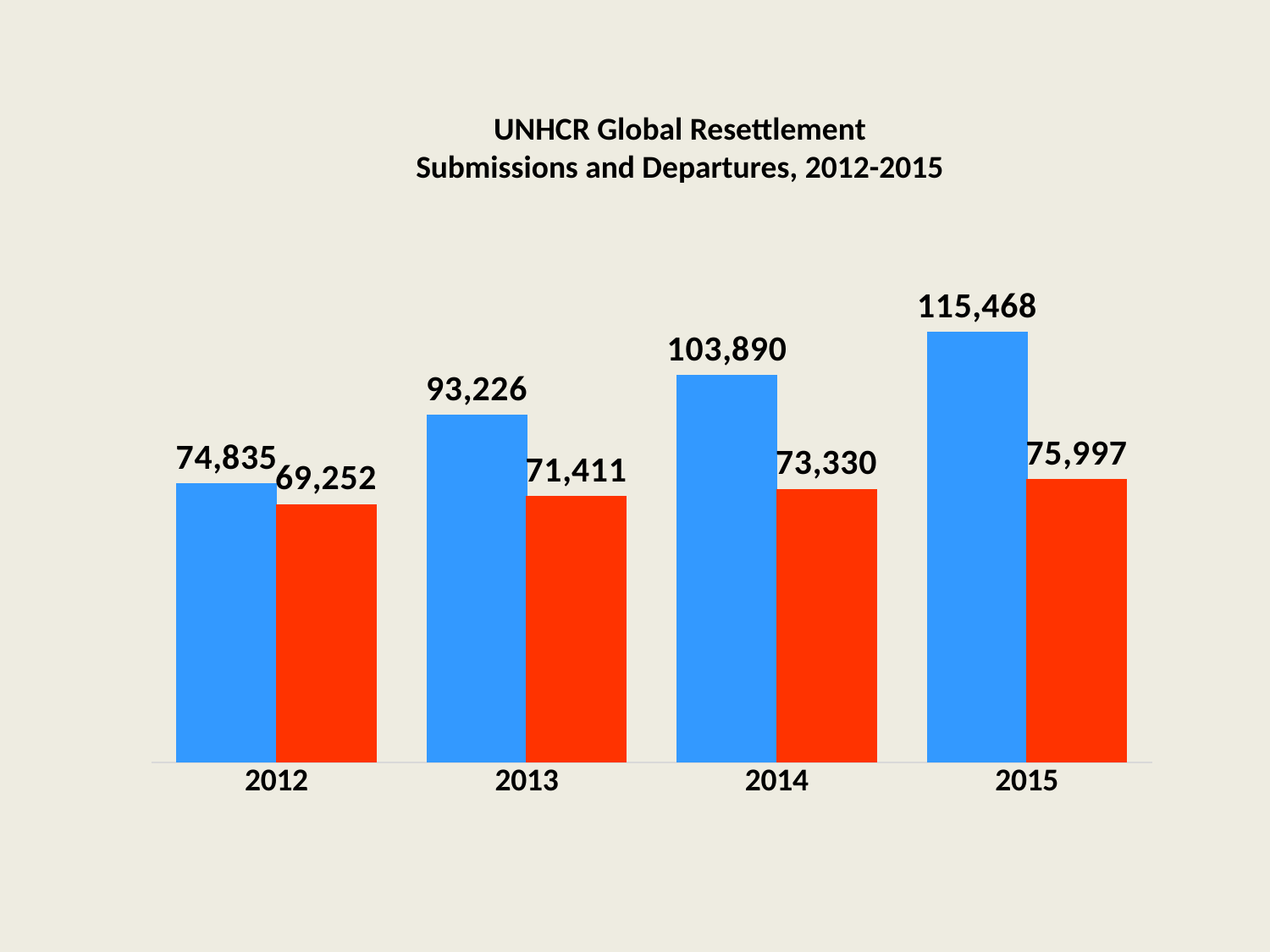
Do the blue bar values rise or fall from 2012 to 2015? rise By how much did the blue bar value increase from 2012 to 2015? 40,633 What is the value of the blue bar for 2012? 74,835 What is the value of the red bar for 2013? 71,411 What is the difference between the blue and red bars for 2015? 39,471 What is the value of the red bar for 2014? 73,330 Which is larger for 2014, the blue bar or the red bar? the blue bar Which year has the lowest red bar? 2012 How many years are shown on the x axis? 4 What is the value of the blue bar for 2015? 115,468 Which year has the highest blue bar? 2015 What kind of chart is shown on the slide? bar chart